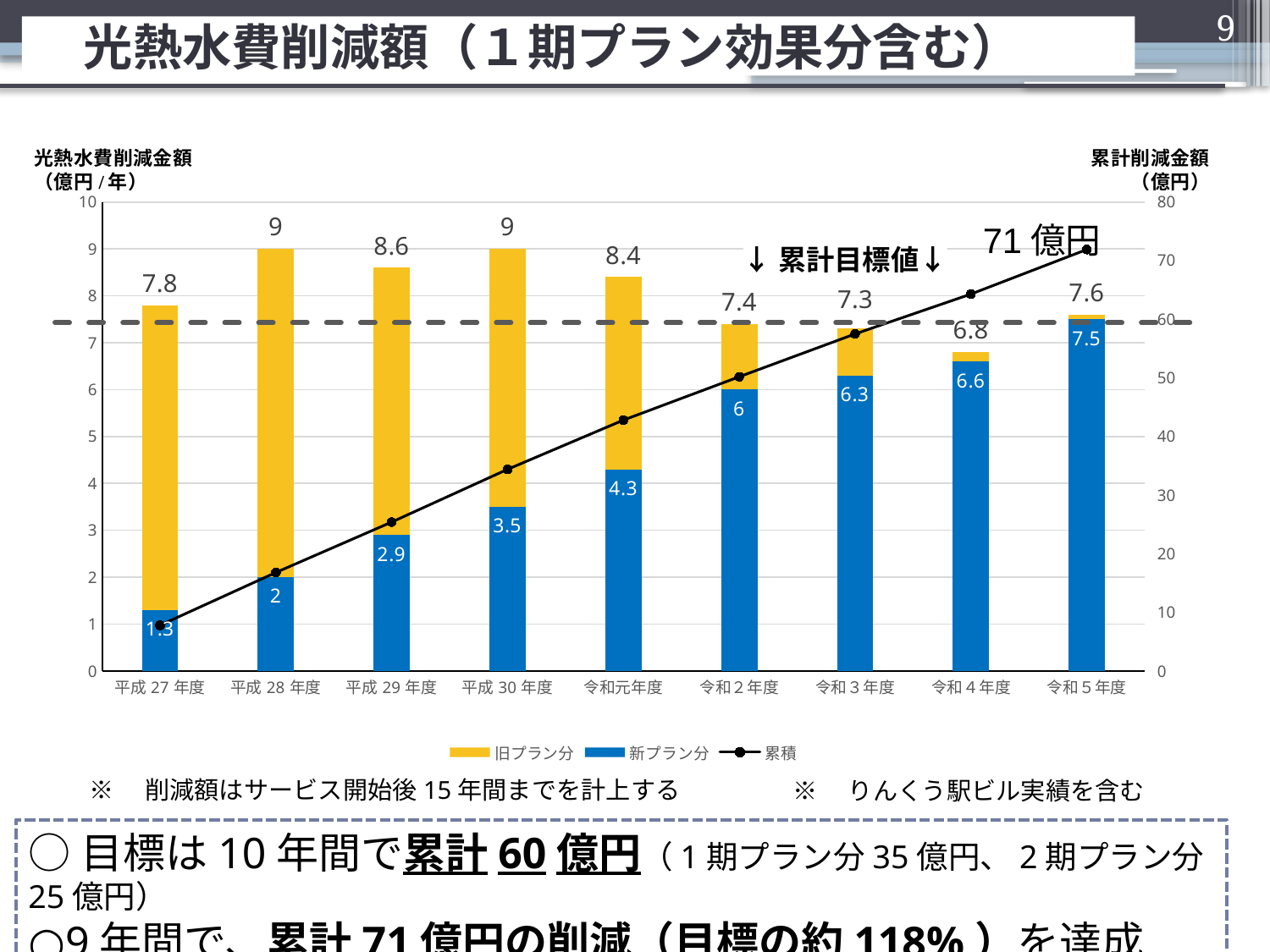
How many series does the legend list? 3 Does the 累積 (cumulative) line rise or fall from 平成27年度 to 令和5年度? Rises What is the value of the 新プラン分 (blue) segment for 令和元年度? 4.3 What is the value of the 新プラン分 (blue) segment for 令和5年度? 7.5 Which fiscal year has the lowest total labelled above its stacked bar? 令和4年度 What is the total value labelled above the stacked bar for 平成28年度? 9 Which is larger, the 新プラン分 value for 令和2年度 or the 新プラン分 value for 平成30年度? 令和2年度 Is the 累積 (cumulative) line value for 令和3年度 greater or less than 50 on the right-hand axis? greater What cumulative value is labelled at the end of the 累積 line for 令和5年度? 71億円 What kind of chart is this? Combined stacked bar and line chart What is the difference between the total labelled for 平成27年度 and the total labelled for 令和4年度? 1 How many fiscal years are shown on the x axis? 9